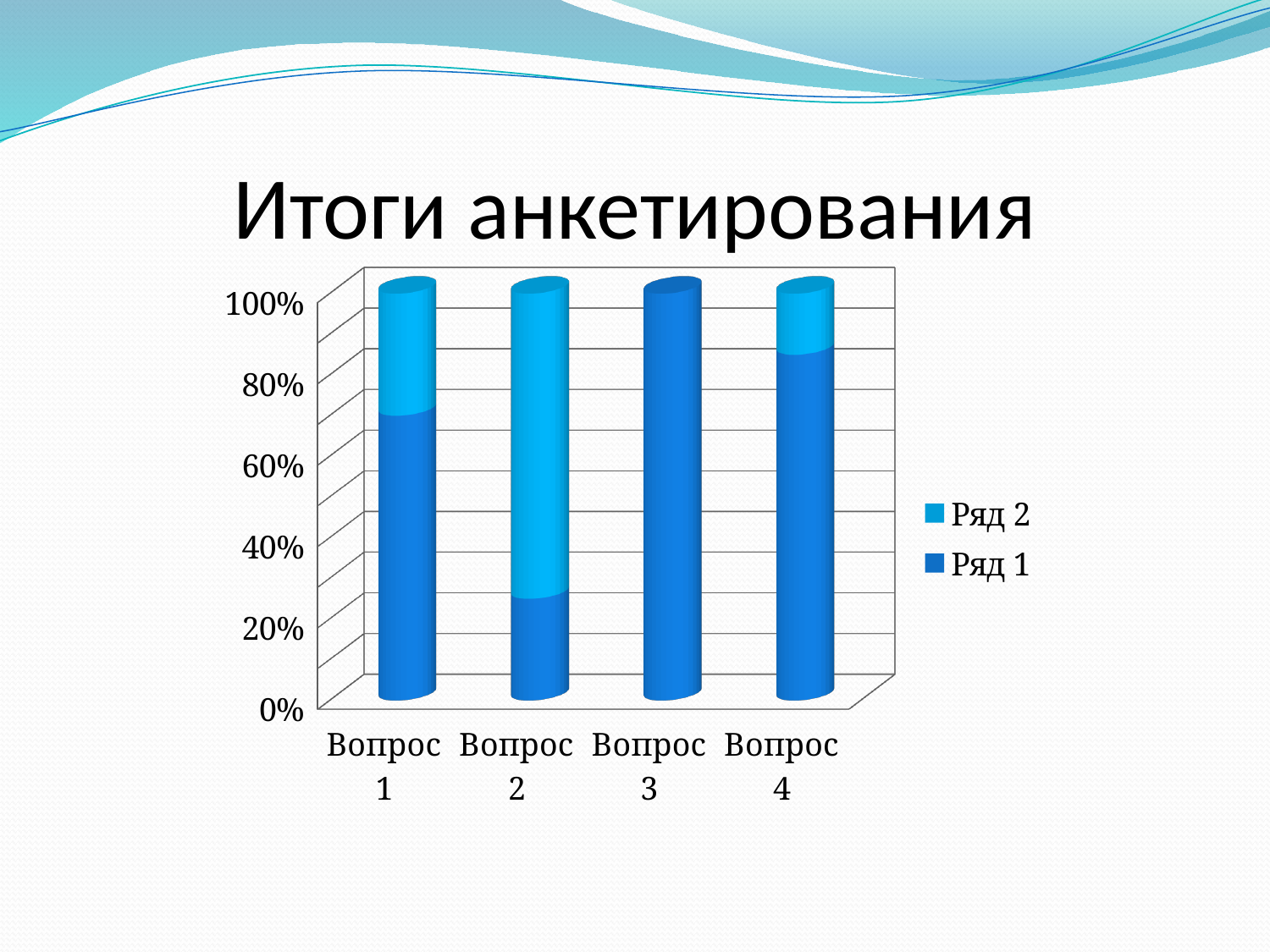
Is the value of Ряд 1 for Вопрос 4 greater or less than 60%? greater How many categories are shown on the x axis? 4 Which category has the highest value for Ряд 2? Вопрос 2 What is the total height of the stacked bar for Вопрос 1? 100% Is the value of Ряд 1 for Вопрос 1 greater or less than 60%? greater What kind of chart is shown on the slide? bar chart Which category has the lowest value for Ряд 1? Вопрос 2 Is the value of Ряд 1 for Вопрос 2 greater or less than 40%? less What is the title of the chart? Итоги анкетирования Which is larger: the Ряд 1 value for Вопрос 1 or for Вопрос 2? Вопрос 1 How many series does the legend list? 2 Which category has the highest value for Ряд 1? Вопрос 3